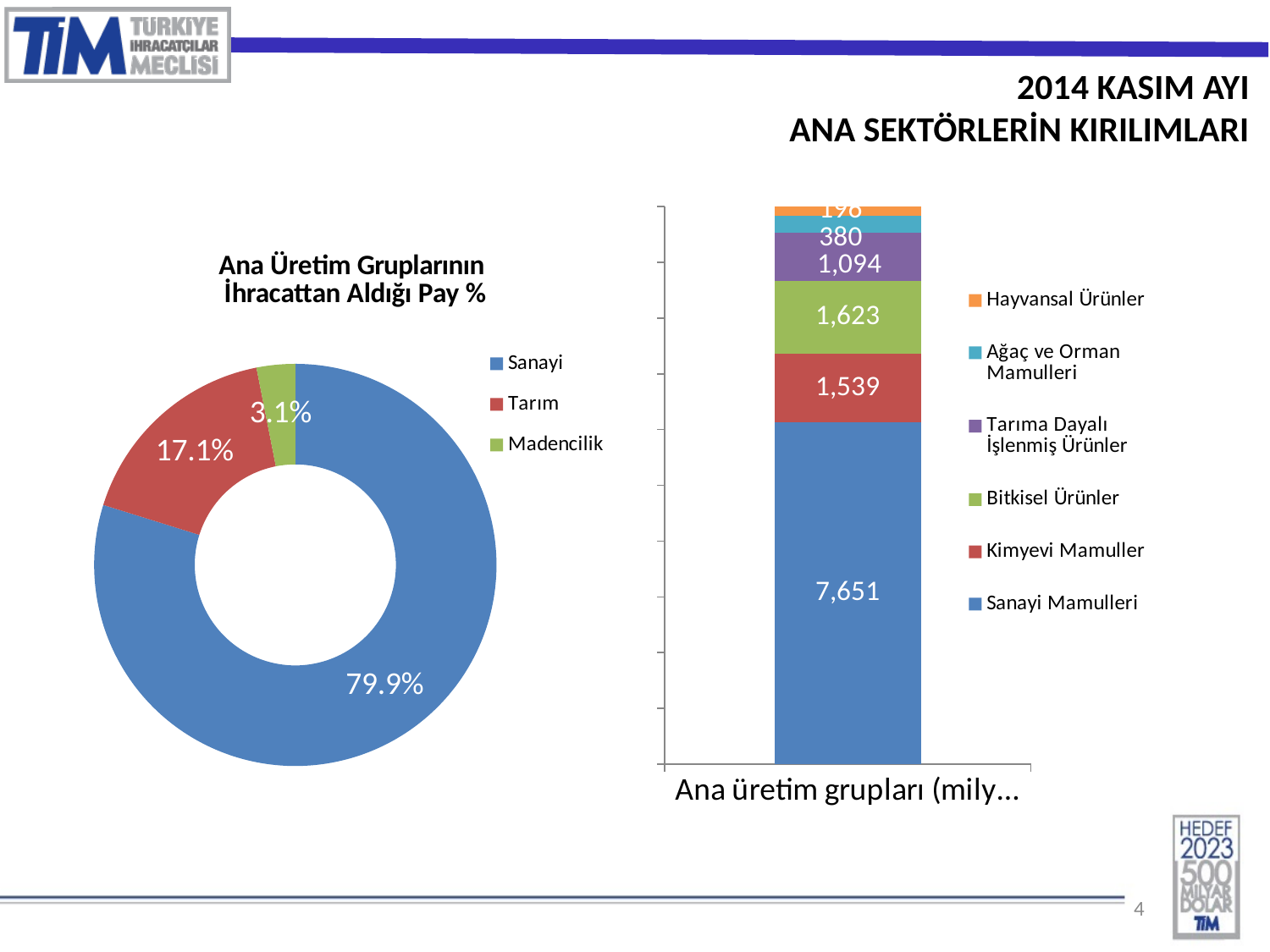
In the stacked bar chart on the right, what is the difference between Bitkisel Ürünler and Kimyevi Mamuller? 84 In the stacked bar chart on the right, what is the value for Sanayi Mamulleri? 7,651 How many categories does the doughnut chart on the left show? 3 In the stacked bar chart on the right, what is the value for Tarıma Dayalı İşlenmiş Ürünler? 1,094 In the stacked bar chart on the right, what is the value for Bitkisel Ürünler? 1,623 In the doughnut chart 'Ana Üretim Gruplarının İhracattan Aldığı Pay %', what share does Tarım have? 17.1% In the doughnut chart 'Ana Üretim Gruplarının İhracattan Aldığı Pay %', what share does Madencilik have? 3.1% In the doughnut chart 'Ana Üretim Gruplarının İhracattan Aldığı Pay %', what share does Sanayi have? 79.9% How many series does the legend of the stacked bar chart on the right list? 6 In the doughnut chart on the left, which category has the largest share? Sanayi In the stacked bar chart on the right, what is the value for Kimyevi Mamuller? 1,539 In the doughnut chart on the left, which category has the smallest share? Madencilik